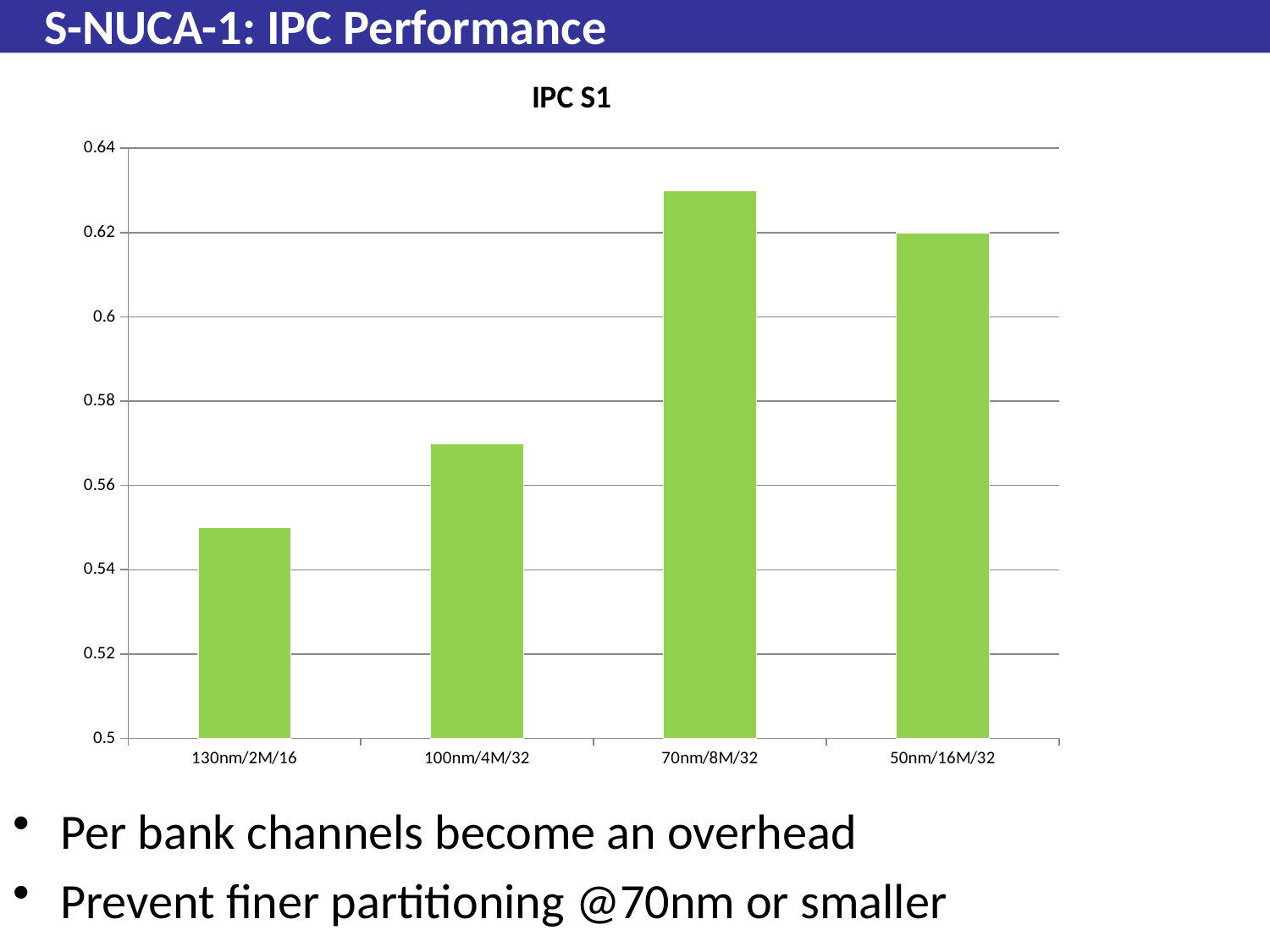
Is the value for 130nm/2M/16 greater or less than 0.56? less Is the value for 100nm/4M/32 greater or less than 0.56? greater Which category has the highest IPC? 70nm/8M/32 Which has the higher IPC, 130nm/2M/16 or 100nm/4M/32? 100nm/4M/32 What kind of chart is shown on the slide? bar chart Which category has the lowest IPC? 130nm/2M/16 How many categories are plotted on the x axis? 4 Which has the higher IPC, 70nm/8M/32 or 50nm/16M/32? 70nm/8M/32 Is the value for 70nm/8M/32 greater or less than 0.62? greater What colour are the bars in the chart? green What is the title of the chart? IPC S1